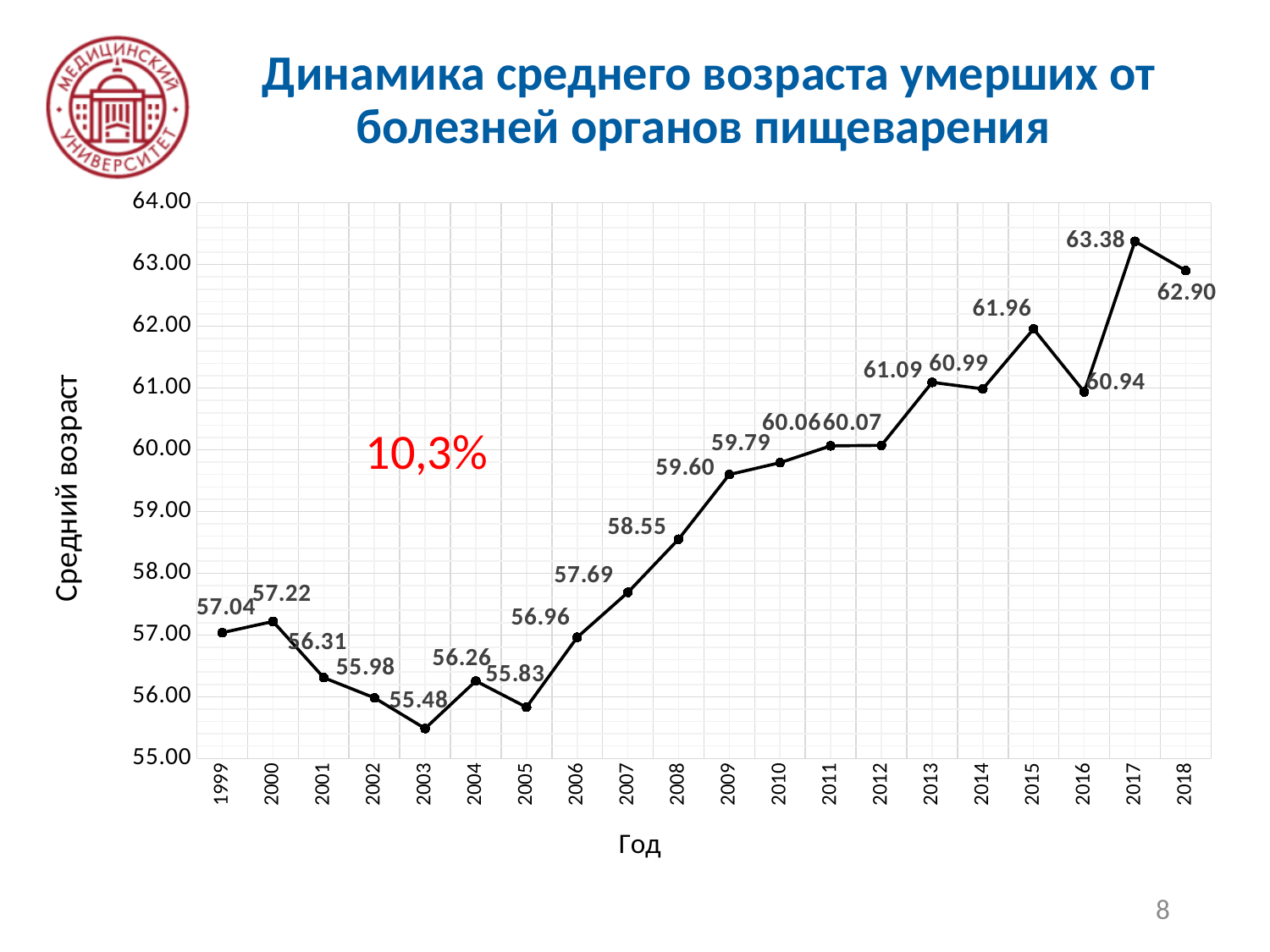
What value is shown for the year 2010? 59.79 What type of chart is shown on the slide? line chart How many years (data points) are plotted on the chart? 20 What is the average age of those who died from digestive diseases in 2003? 55.48 Which year has the highest average age on the chart? 2017 Which year has the lowest average age on the chart? 2003 What is the label of the vertical axis? Средний возраст What is the difference between the values for 2017 and 2016? 2.44 Does the average age generally rise or fall from 1999 to 2018? rise What value is shown for the year 2017? 63.38 Which year has the larger value, 2013 or 2014? 2013 By how much did the average age increase from 1999 to 2018? 5.86